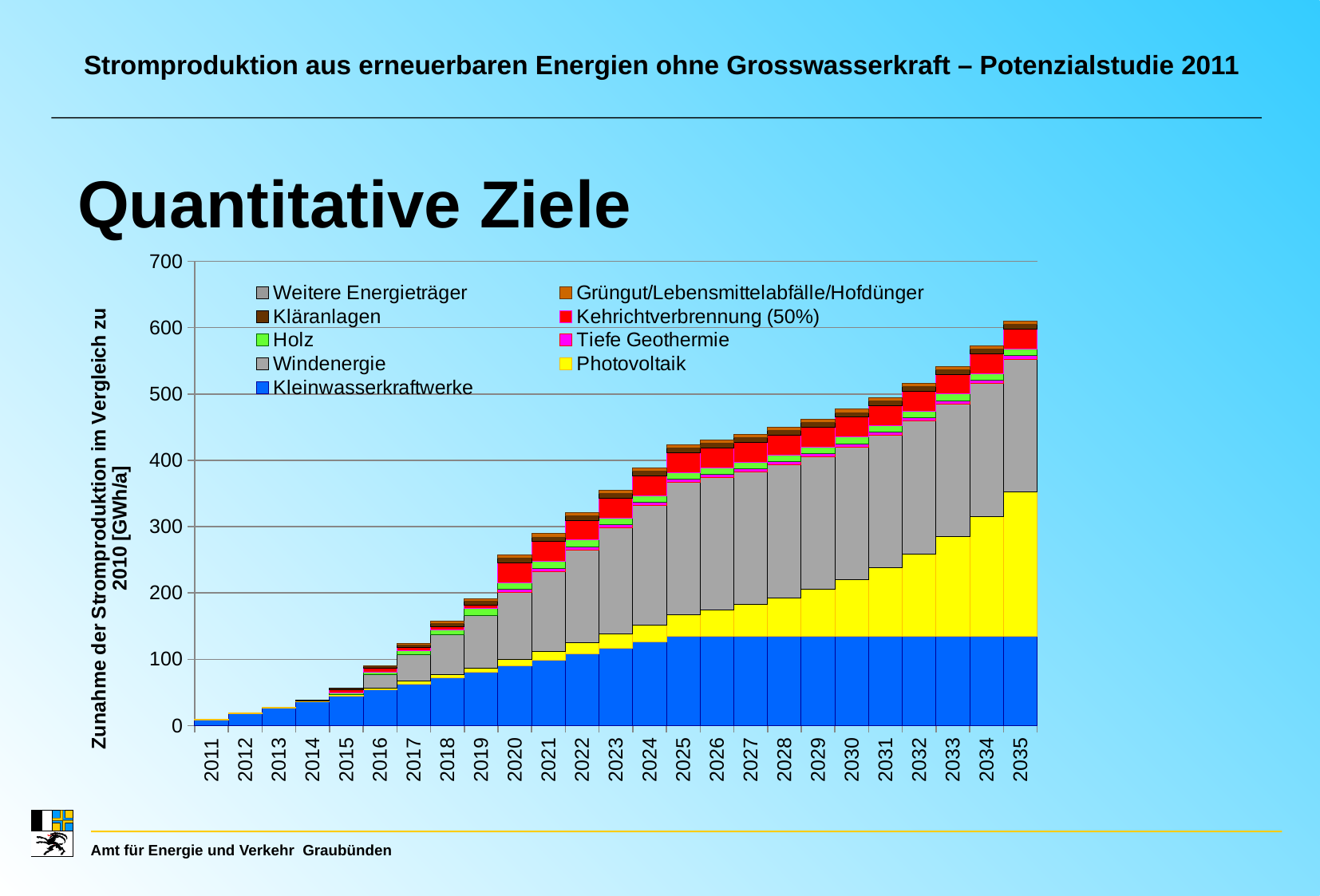
What is the label of the chart's y axis? Zunahme der Stromproduktion im Vergleich zu 2010 [GWh/a] How many series does the chart's legend list? 9 Which year has the highest total bar? 2035 What kind of chart is shown on the slide? stacked bar chart Which year has the lowest total bar? 2011 Do the total bar heights rise or fall from 2011 to 2035? rise Is the total value for 2020 greater or less than 300? less How many years are shown along the x axis of the chart? 25 Is the total value for 2035 greater or less than 500? greater Which year has the larger total bar, 2020 or 2030? 2030 Which colour represents Photovoltaik in the chart? yellow Is the total value for 2015 greater or less than 100? less